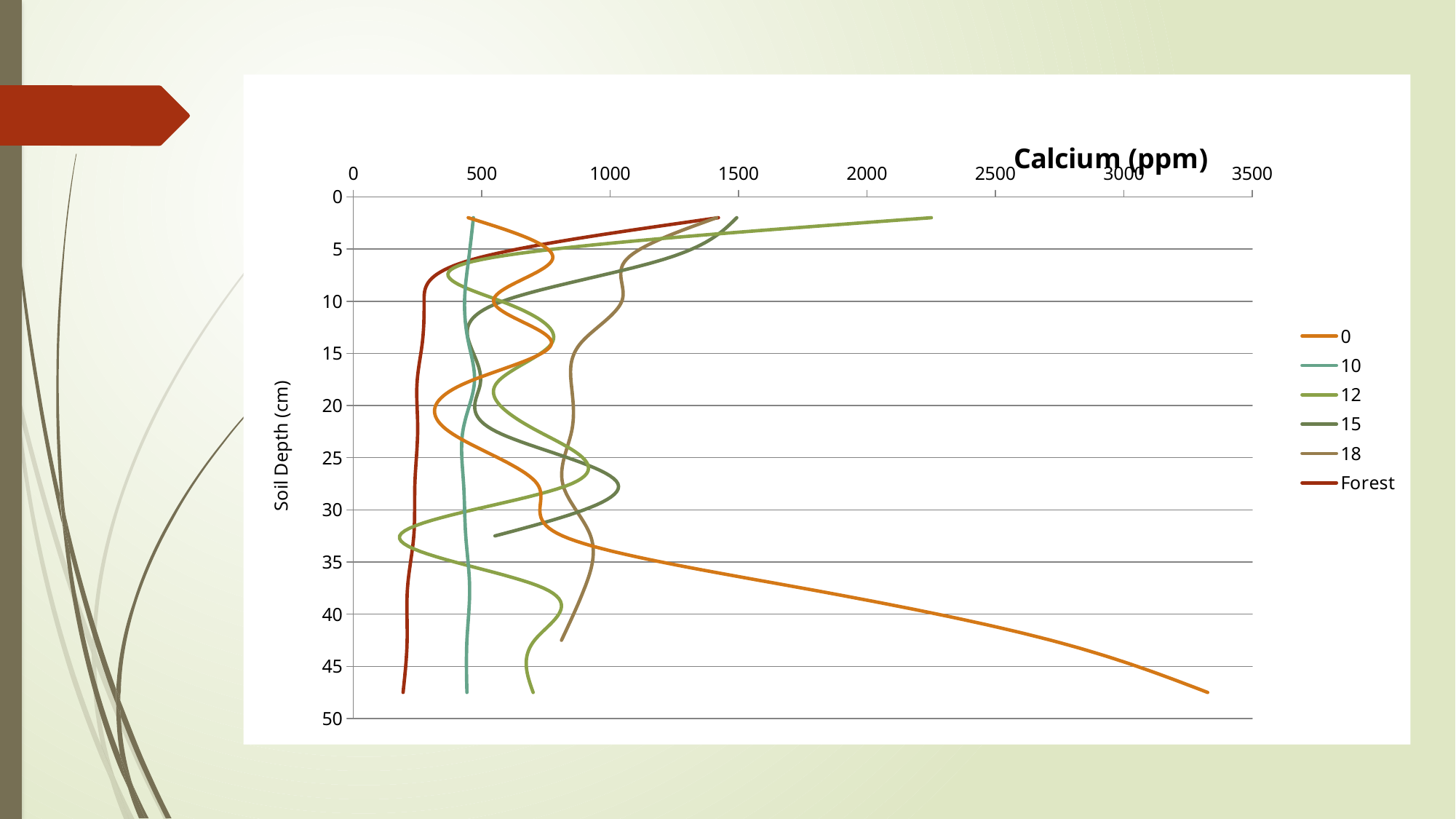
What kind of chart is shown on the slide? line chart What are the series names listed in the legend? 0, 10, 12, 15, 18, Forest What is the title of the chart? Calcium (ppm) At the shallowest depth (about 2 cm), which series has the higher calcium value, 12 or Forest? 12 Which series reaches the highest calcium value anywhere on the chart? 0 Is the calcium value for series 10 at 45 cm depth greater or less than 500? less At the deepest point (about 47.5 cm), which series has the higher calcium value, 0 or 10? 0 How many series does the legend list? 6 Is the calcium value for series 0 at the deepest point (about 47.5 cm) greater or less than 3000? greater Is the calcium value for series 12 at its shallowest point (about 2 cm) greater or less than 2000? greater